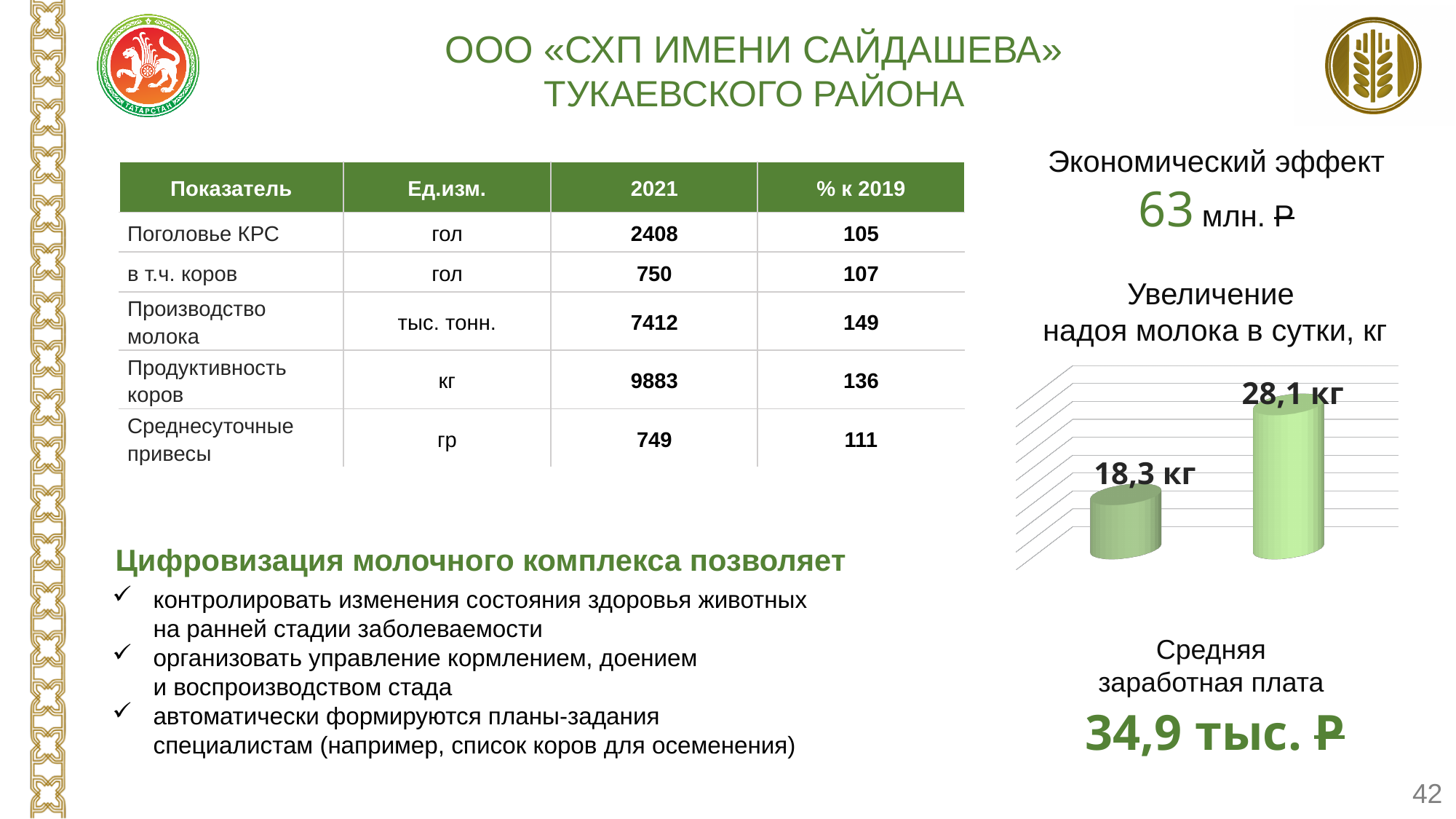
What is the value shown on the left bar of the chart? 18,3 кг What colour are the bars in the chart? green What is the title of the chart on the slide? Увеличение надоя молока в сутки, кг What is the value shown on the right bar of the chart? 28,1 кг Is the value of the right bar larger or smaller than the value of the left bar? larger What kind of chart is shown on the slide? bar chart Do the values in the chart rise or fall from left to right? rise Which bar in the chart has the lower value, the left or the right? the left Which bar in the chart has the higher value, the left or the right? the right What is the difference between the right bar's value and the left bar's value in the chart? 9,8 кг How many bars are plotted in the chart? 2